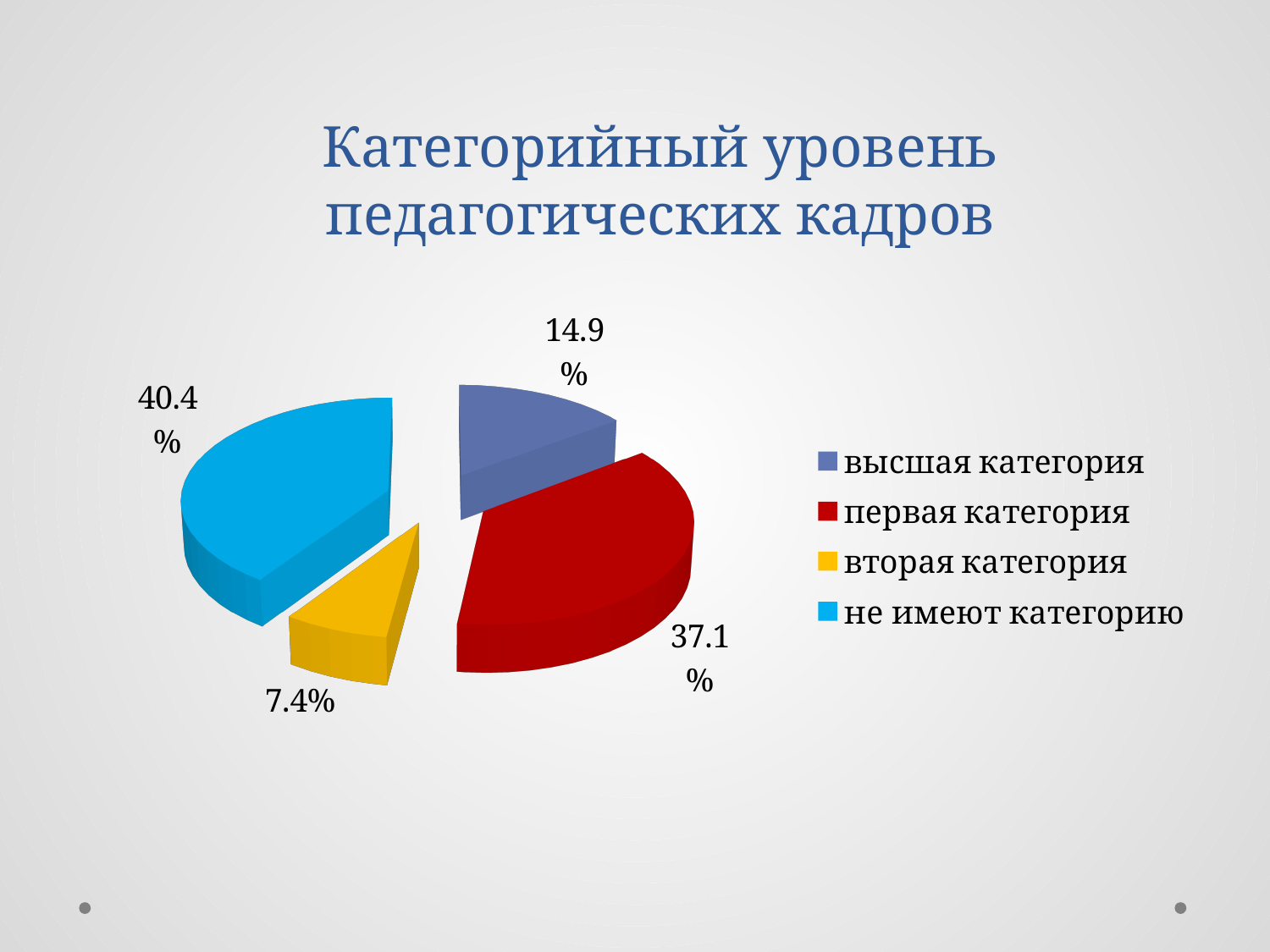
What is the difference between the shares of 'не имеют категорию' and 'первая категория'? 3.3% What is the difference between the shares of 'высшая категория' and 'вторая категория'? 7.5% What kind of chart is shown on the slide? pie chart How many categories are shown in the pie chart? 4 Which is larger: the share of 'первая категория' or the share of 'высшая категория'? первая категория Which category has the largest slice of the pie? не имеют категорию What share of the pie does 'высшая категория' have? 14.9% Which category has the smallest slice of the pie? вторая категория What share of the pie does 'первая категория' have? 37.1% What is the title of the chart on the slide? Категорийный уровень педагогических кадров What share of the pie does 'вторая категория' have? 7.4% What share of the pie does 'не имеют категорию' have? 40.4%